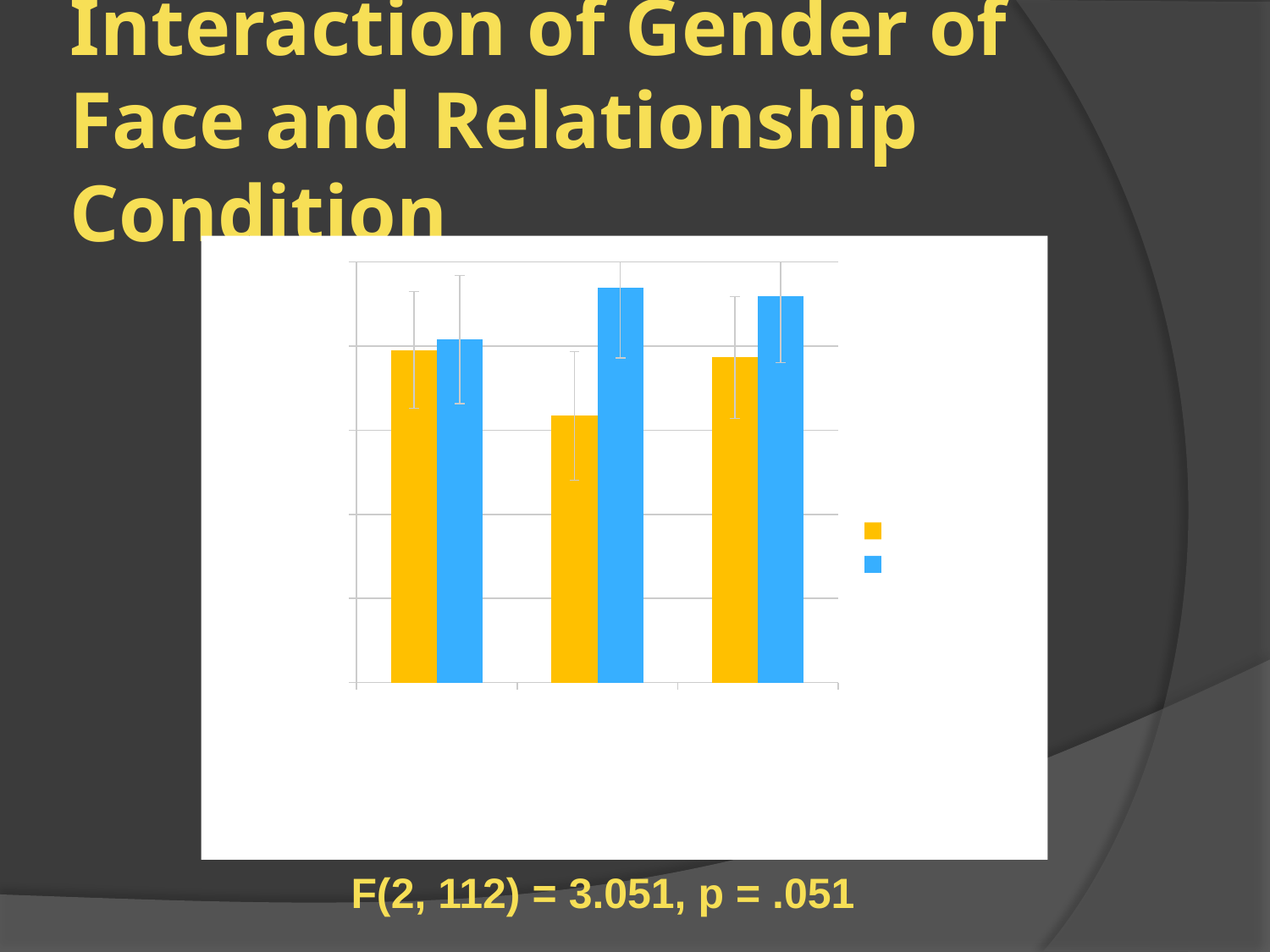
In the rightmost group of bars, which bar is taller, the yellow one or the blue one? the blue one Does the chart show error bars on the bars? yes How many series does the legend list? 2 In the leftmost group, is the blue bar taller or shorter than the yellow bar? taller Which of the three blue bars is the shortest? the leftmost one In the middle group of bars, which bar is taller, the yellow one or the blue one? the blue one What kind of chart is shown on the slide? bar chart What colours are the two series in the chart? yellow and blue Which of the three yellow bars is the shortest? the middle one How many groups of bars are plotted along the x axis? 3 Which of the three yellow bars is the tallest? the leftmost one